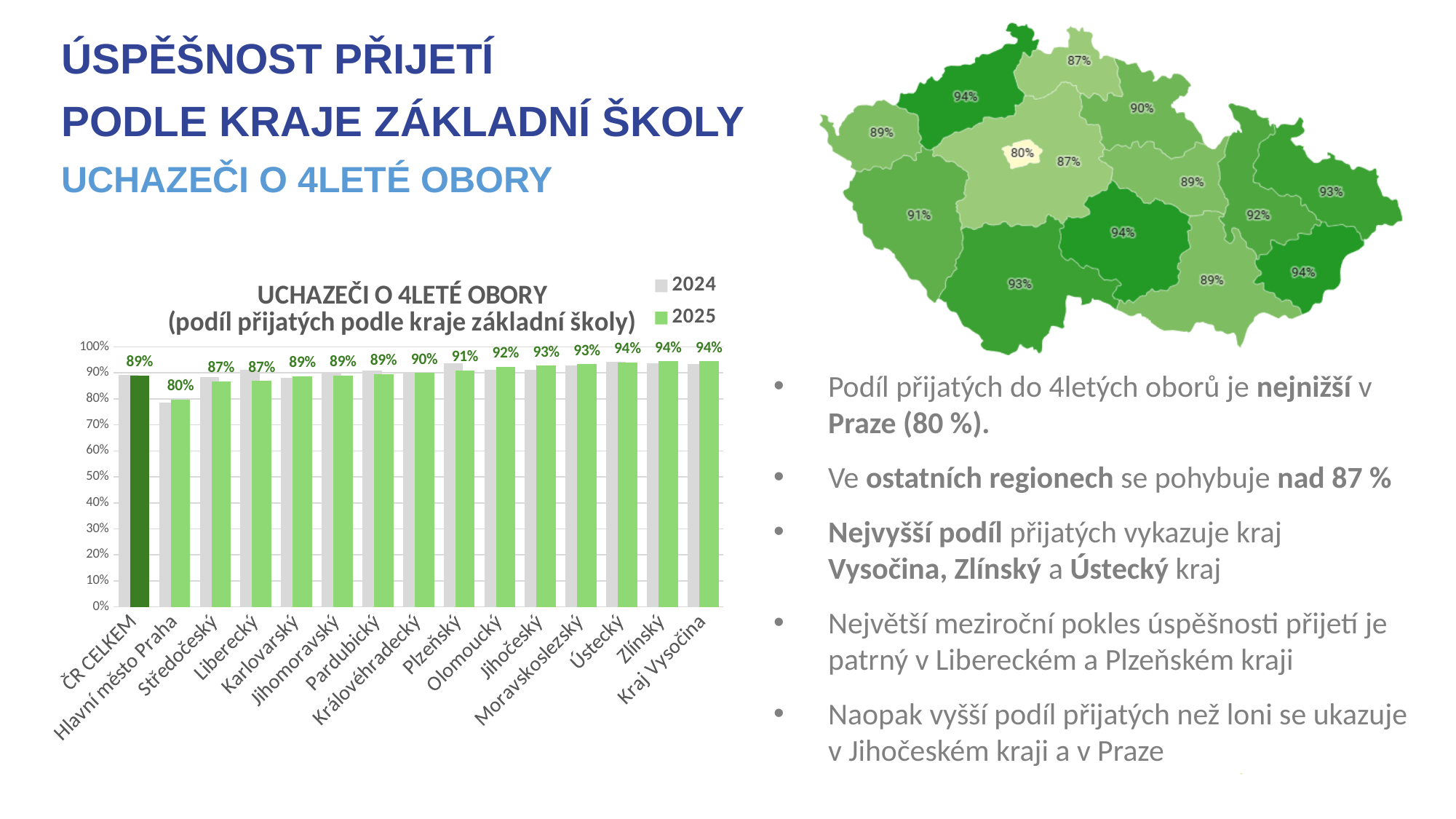
Which colour represents the 2024 series in the bar chart legend? grey How many categories are shown on the x axis of the bar chart? 15 What is the 2025 value for Plzeňský in the bar chart? 91% What kind of chart is shown on the left of the slide? bar chart Is the 2024 value for Hlavní město Praha in the bar chart greater or less than 90%? less How many series does the legend of the bar chart list? 2 Which has the larger 2025 value in the bar chart, Olomoucký or Středočeský? Olomoucký What is the difference between the 2025 values for Kraj Vysočina and Hlavní město Praha in the bar chart? 14% What is the 2025 value for Hlavní město Praha in the bar chart? 80% What is the 2025 value for ČR CELKEM in the bar chart? 89% Which category has the lowest 2025 value in the bar chart? Hlavní město Praha Do the 2025 values in the bar chart generally rise or fall from Hlavní město Praha to Kraj Vysočina along the x axis? rise